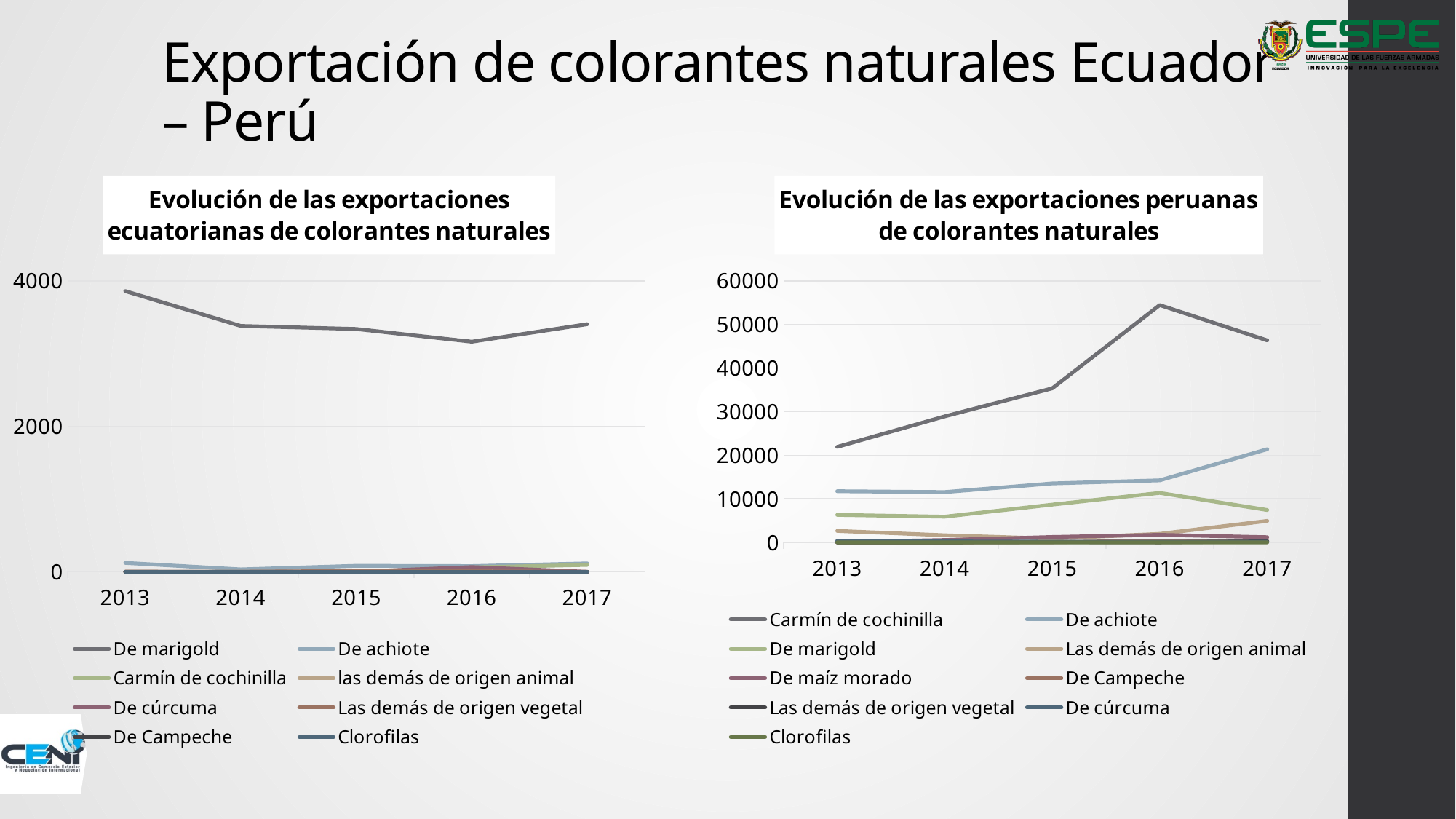
In the right chart (Peruvian exports), which series has the highest values across all years? Carmín de cochinilla In the right chart (Peruvian exports), how many series does the legend list? 9 In the left chart (Ecuadorian exports), which series has the highest values across all years? De marigold What kind of chart is the chart titled 'Evolución de las exportaciones peruanas de colorantes naturales'? Line chart What kind of chart is the chart titled 'Evolución de las exportaciones ecuatorianas de colorantes naturales'? Line chart In the left chart (Ecuadorian exports), how many series does the legend list? 8 In the right chart (Peruvian exports), which year is the last one shown on the x axis? 2017 In the right chart (Peruvian exports), is the value for Carmín de cochinilla in 2016 greater or less than 50000? greater In the left chart (Ecuadorian exports), how many years are shown on the x axis? 5 In the left chart (Ecuadorian exports), is the value for De marigold in 2013 greater or less than 2000? greater In the right chart (Peruvian exports), is the value for De marigold in 2017 greater or less than 10000? less In the right chart (Peruvian exports), does the Carmín de cochinilla line rise or fall from 2013 to 2016? Rise